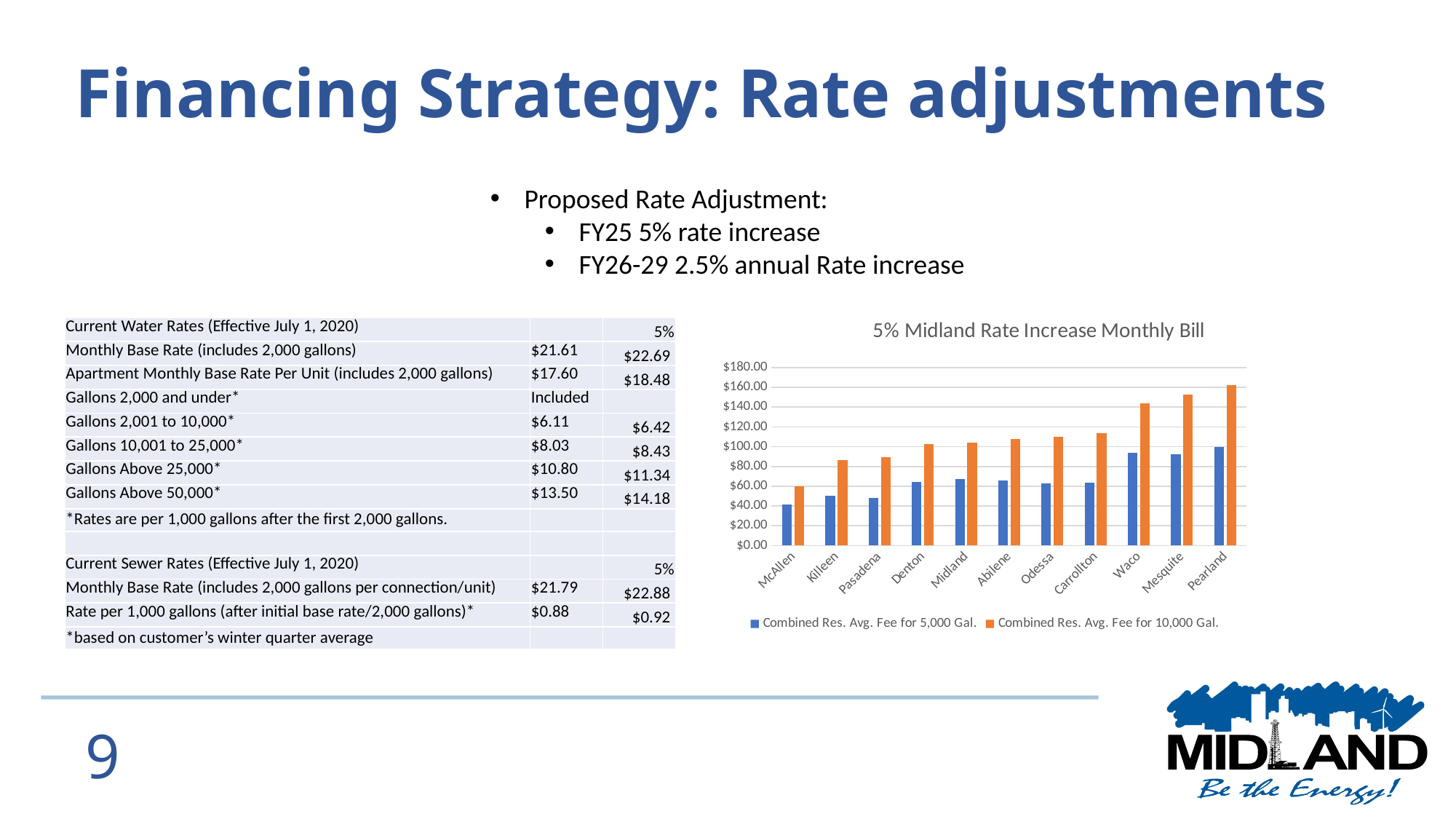
How many series does the legend of the "5% Midland Rate Increase Monthly Bill" chart list? 2 In the "5% Midland Rate Increase Monthly Bill" chart, do the Combined Res. Avg. Fee for 10,000 Gal. values generally rise or fall from McAllen to Pearland? Rise In the "5% Midland Rate Increase Monthly Bill" chart, which city has the highest Combined Res. Avg. Fee for 10,000 Gal.? Pearland In the "5% Midland Rate Increase Monthly Bill" chart, which city has the lowest Combined Res. Avg. Fee for 5,000 Gal.? McAllen In the "5% Midland Rate Increase Monthly Bill" chart, is the Combined Res. Avg. Fee for 10,000 Gal. for Pearland greater or less than $140.00? greater How many cities are shown on the x axis of the "5% Midland Rate Increase Monthly Bill" chart? 11 In the "5% Midland Rate Increase Monthly Bill" chart, which city has the lowest Combined Res. Avg. Fee for 10,000 Gal.? McAllen In the "5% Midland Rate Increase Monthly Bill" chart, which is larger: the Combined Res. Avg. Fee for 10,000 Gal. for Waco or for Denton? Waco In the "5% Midland Rate Increase Monthly Bill" chart, what colour are the bars for Combined Res. Avg. Fee for 10,000 Gal.? Orange In the "5% Midland Rate Increase Monthly Bill" chart, is the Combined Res. Avg. Fee for 5,000 Gal. for McAllen greater or less than $60.00? less What kind of chart is shown under the title "5% Midland Rate Increase Monthly Bill"? Bar chart In the "5% Midland Rate Increase Monthly Bill" chart, is the Combined Res. Avg. Fee for 10,000 Gal. for Waco greater or less than $120.00? greater